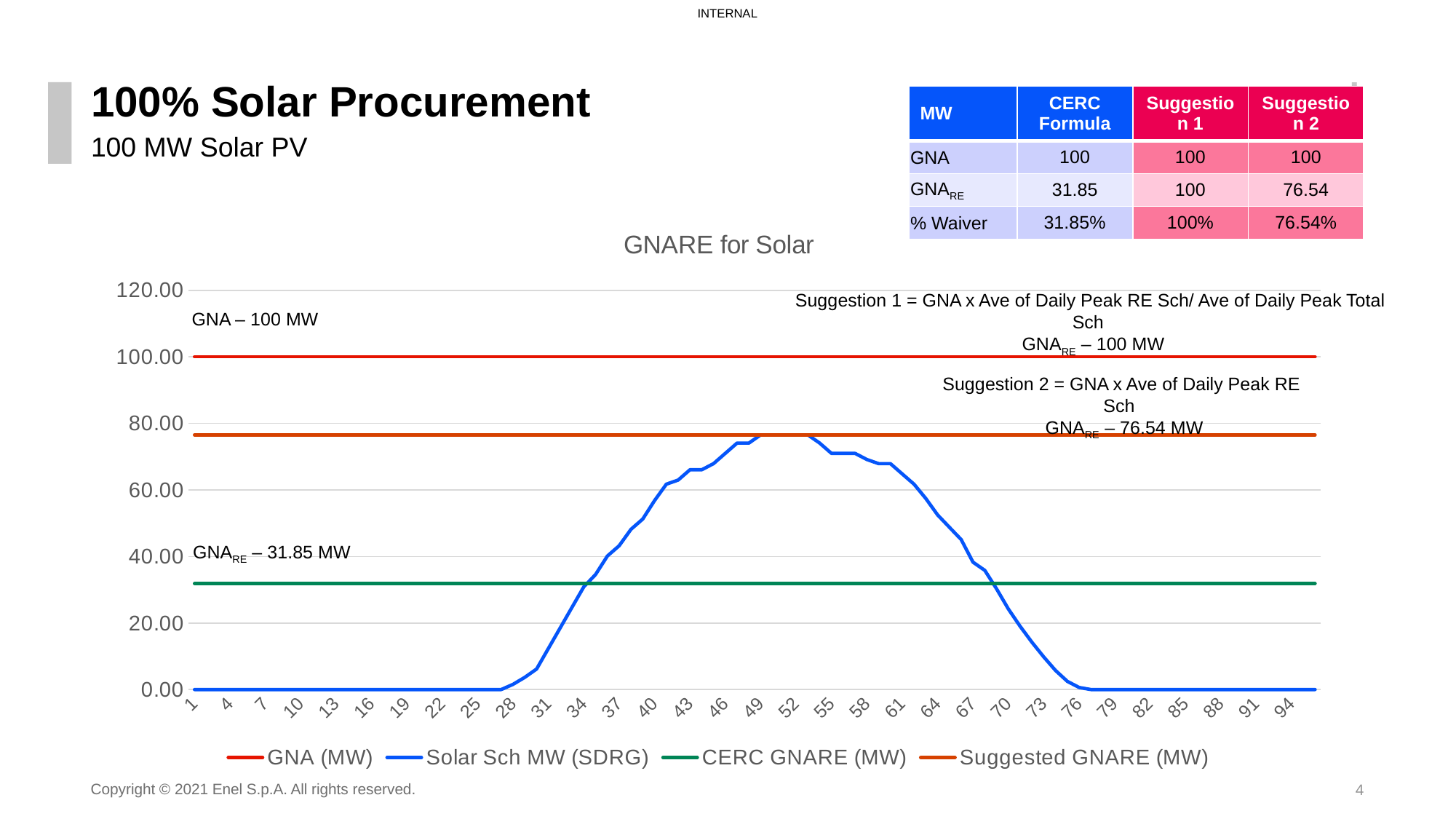
What kind of chart is shown on the slide? line chart What value does the GNA (MW) line sit at, according to the label on the chart? 100 MW Which is higher, the Suggested GNARE (MW) line or the CERC GNARE (MW) line? Suggested GNARE (MW) Is the Solar Sch MW (SDRG) value at x = 31 greater or less than 20? less What is the difference between the GNA (MW) line and the CERC GNARE (MW) line? 68.15 MW Is the Solar Sch MW (SDRG) value at x = 49 greater or less than 60? greater What value does the CERC GNARE (MW) line sit at, according to the label on the chart? 31.85 MW Does the Solar Sch MW (SDRG) line rise or fall between x = 52 and x = 76? fall What is the title of the chart? GNARE for Solar What value does the Suggested GNARE (MW) line sit at, according to the label on the chart? 76.54 MW How many series does the chart legend list? 4 Which of the horizontal lines has the lowest value? CERC GNARE (MW)